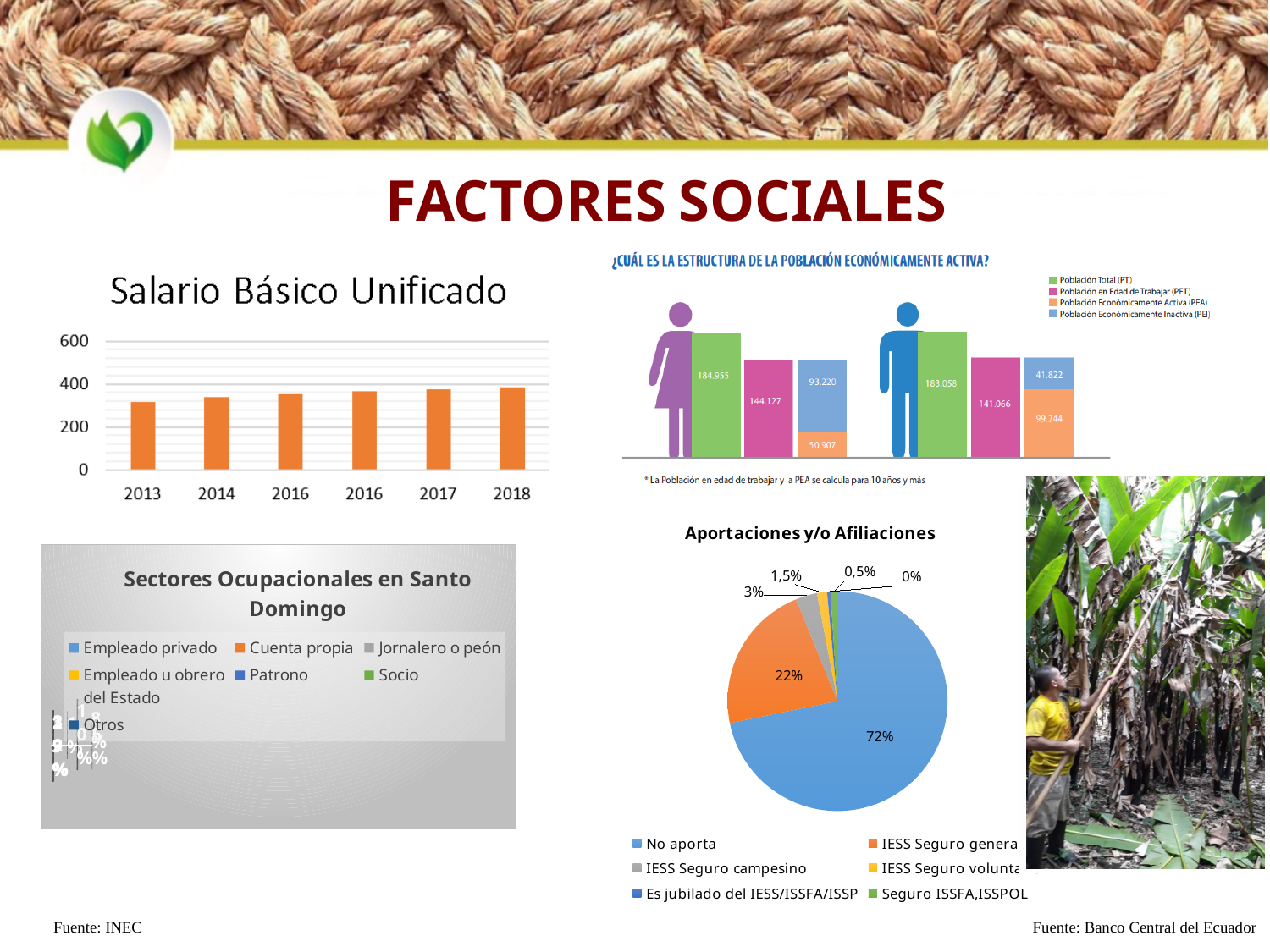
In the 'Salario Básico Unificado' chart, which year has the highest bar? 2018 In the 'Salario Básico Unificado' chart, what kind of chart is shown? bar chart In the 'Aportaciones y/o Afiliaciones' pie chart, what is the difference between the 'No aporta' and 'IESS Seguro general' shares? 50% In the 'Aportaciones y/o Afiliaciones' pie chart, what share is labelled for 'IESS Seguro campesino'? 3% In the 'Salario Básico Unificado' chart, is the value for 2018 greater or less than 200? greater In the 'Sectores Ocupacionales en Santo Domingo' chart, how many entries does the legend list? 7 In the 'Salario Básico Unificado' chart, how many bars are plotted? 6 In the 'Aportaciones y/o Afiliaciones' pie chart, what share is labelled for 'IESS Seguro general'? 22% In the 'Aportaciones y/o Afiliaciones' pie chart, what share is labelled for 'No aporta'? 72% In the 'Salario Básico Unificado' chart, do the values rise or fall from 2013 to 2018? rise In the 'Aportaciones y/o Afiliaciones' pie chart, which category has the largest slice? No aporta In the 'Salario Básico Unificado' chart, is the value for 2013 greater or less than 400? less